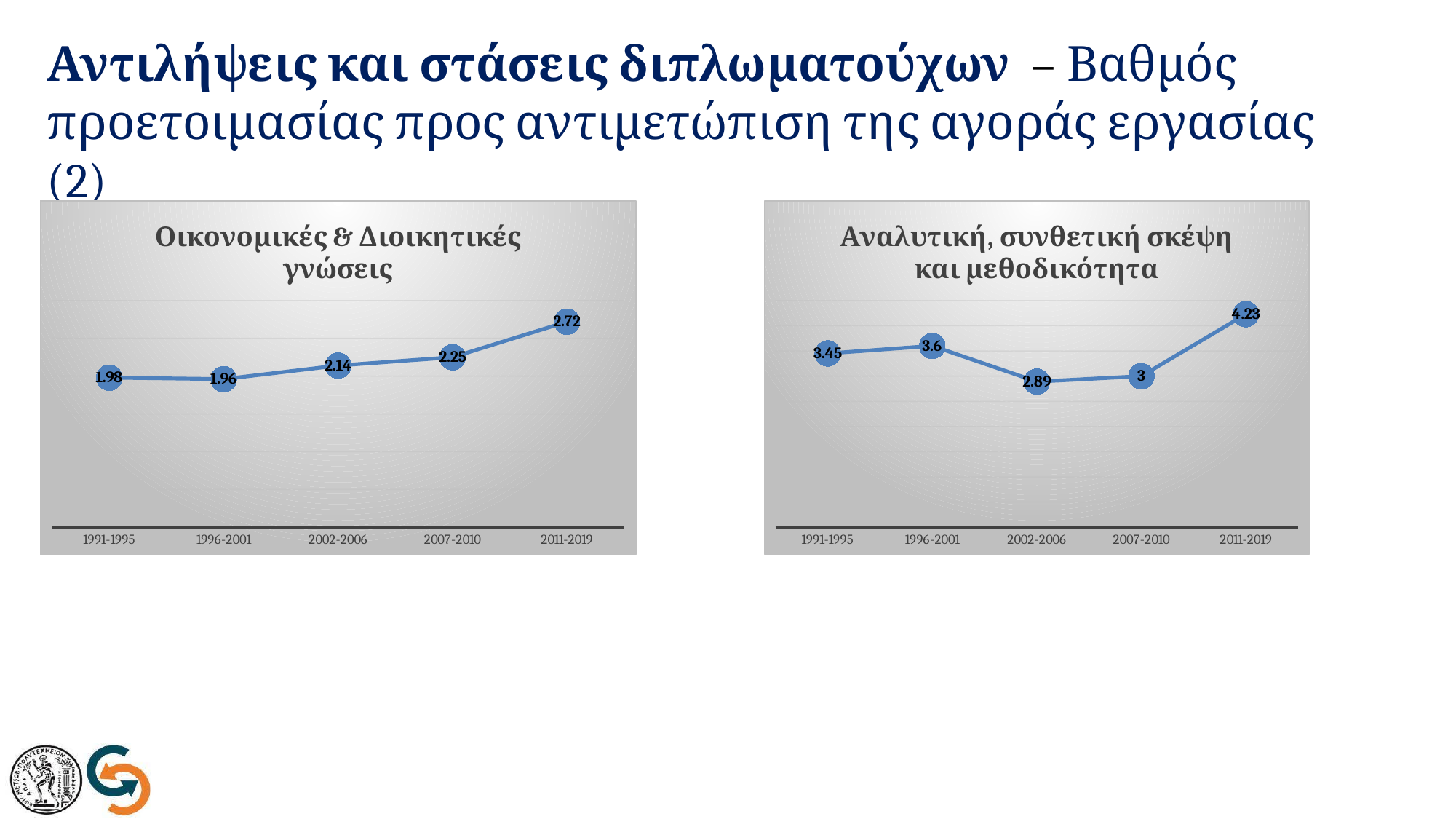
In the left chart 'Οικονομικές & Διοικητικές γνώσεις', which period has the highest value? 2011-2019 In the right chart 'Αναλυτική, συνθετική σκέψη και μεθοδικότητα', what is the value for 2002-2006? 2.89 In the left chart 'Οικονομικές & Διοικητικές γνώσεις', what is the value for 2011-2019? 2.72 In the left chart 'Οικονομικές & Διοικητικές γνώσεις', do the values generally rise or fall from 1996-2001 to 2011-2019? Rise In the right chart 'Αναλυτική, συνθετική σκέψη και μεθοδικότητα', what is the value for 2007-2010? 3 In the left chart 'Οικονομικές & Διοικητικές γνώσεις', what is the value for 1996-2001? 1.96 In the right chart 'Αναλυτική, συνθετική σκέψη και μεθοδικότητα', which period has the lowest value? 2002-2006 In the right chart 'Αναλυτική, συνθετική σκέψη και μεθοδικότητα', what is the difference between the values for 2011-2019 and 1991-1995? 0.78 In the left chart 'Οικονομικές & Διοικητικές γνώσεις', what is the difference between the values for 2011-2019 and 2007-2010? 0.47 What kind of chart is the right chart 'Αναλυτική, συνθετική σκέψη και μεθοδικότητα'? Line chart In the right chart 'Αναλυτική, συνθετική σκέψη και μεθοδικότητα', which is larger: the value for 1996-2001 or the value for 2007-2010? 1996-2001 How many periods are shown on the x axis of the left chart 'Οικονομικές & Διοικητικές γνώσεις'? 5